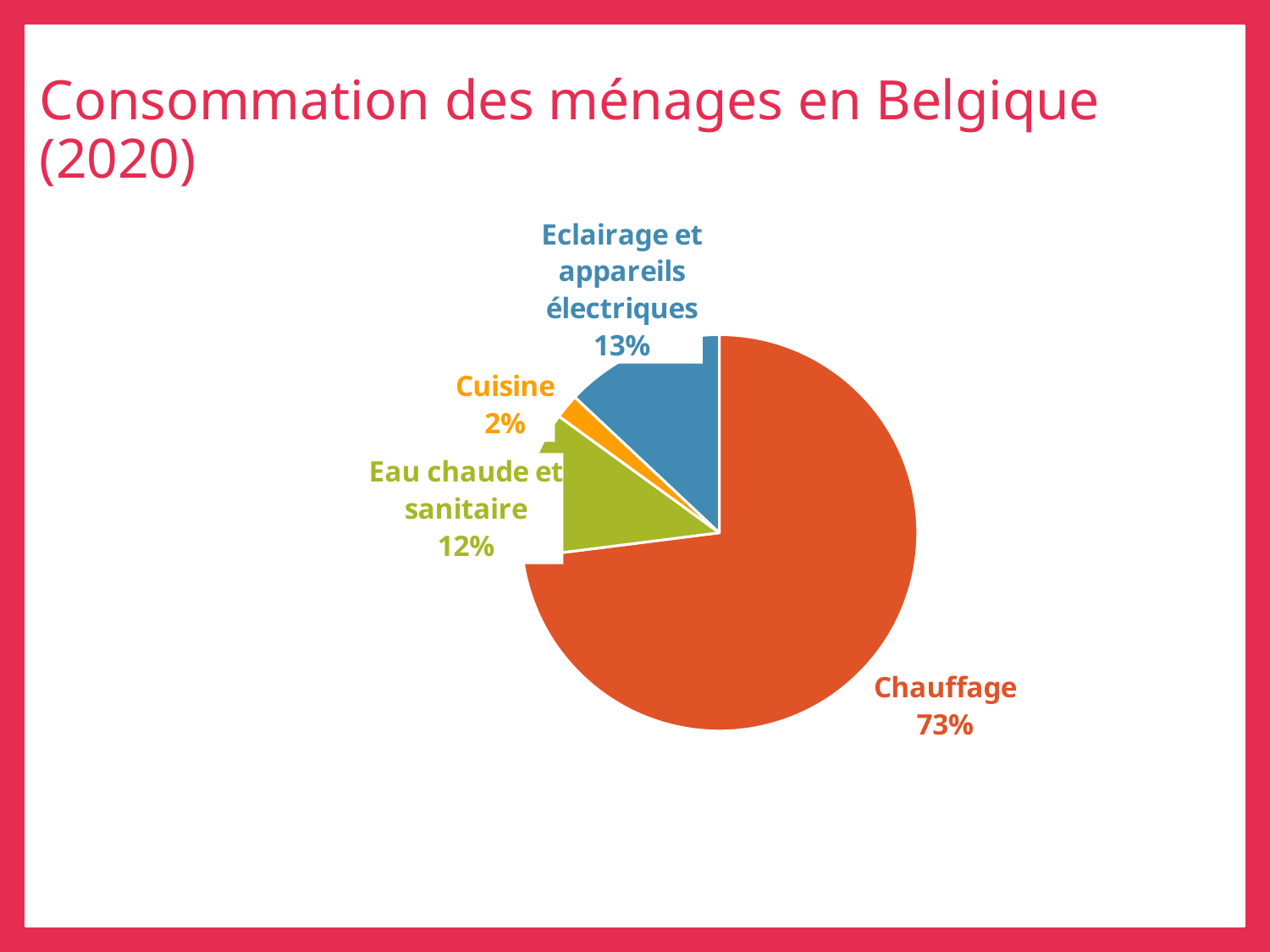
What is the difference in percentage points between Chauffage and Eau chaude et sanitaire? 61 What share of household consumption does Chauffage account for? 73% What share of household consumption does Eau chaude et sanitaire account for? 12% Which category has the largest share of the pie? Chauffage What is the difference in percentage points between Eclairage et appareils électriques and Cuisine? 11 What is the title of the slide containing the chart? Consommation des ménages en Belgique (2020) What share of household consumption does Eclairage et appareils électriques account for? 13% Which is larger, the share for Eclairage et appareils électriques or the share for Cuisine? Eclairage et appareils électriques What kind of chart is shown on the slide? Pie chart How many categories are shown in the pie chart? 4 Which category has the smallest share of the pie? Cuisine